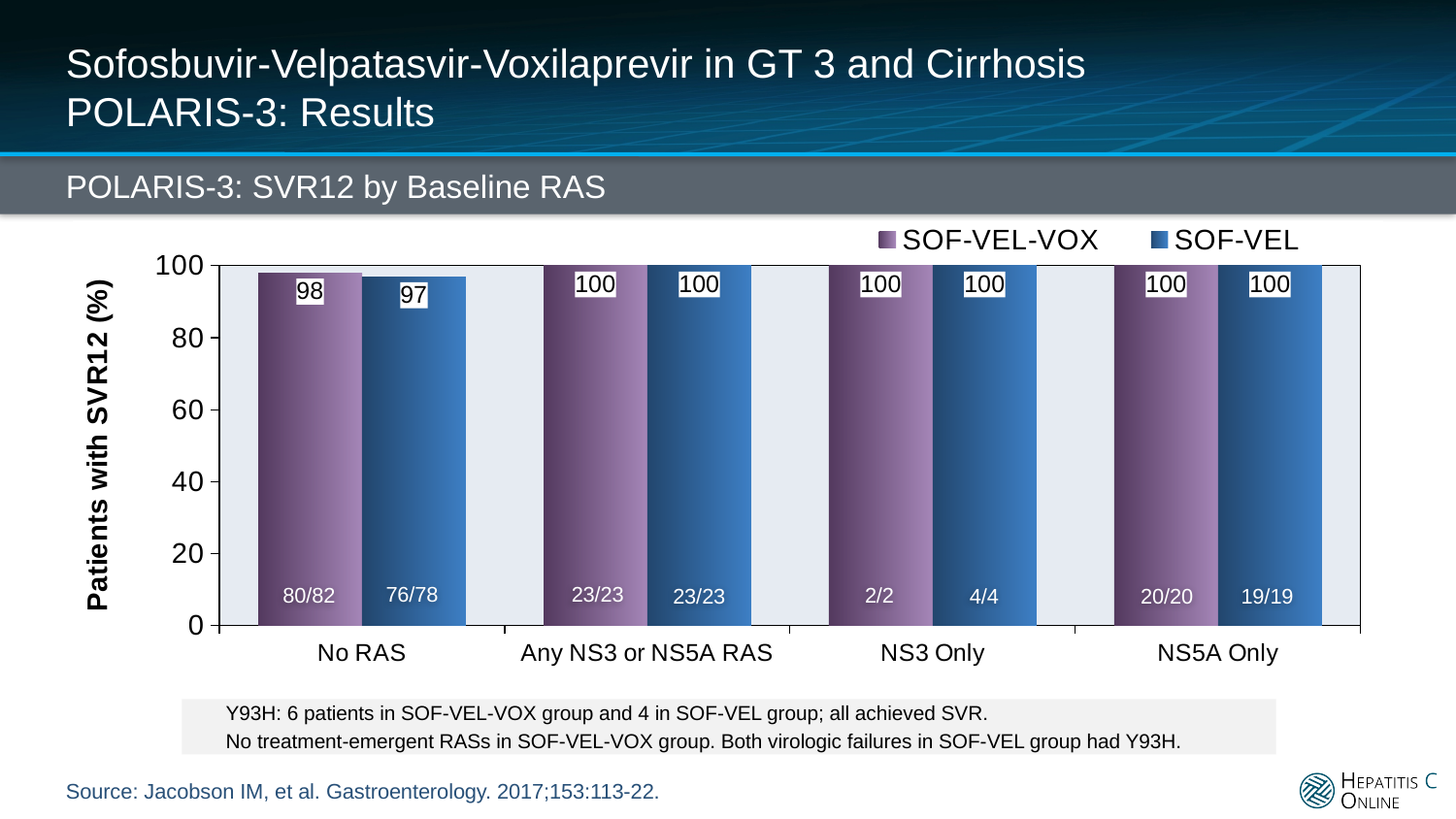
What is the patient fraction shown for SOF-VEL-VOX in the NS5A Only group? 20/20 What is the SVR12 rate for SOF-VEL-VOX in the No RAS group? 98 How many categories are shown on the x axis? 4 What is the difference between the SOF-VEL-VOX and SOF-VEL SVR12 rates in the No RAS group? 1 How many series does the legend list? 2 What is the label of the y axis? Patients with SVR12 (%) What kind of chart is shown on the slide? Bar chart What is the SVR12 rate for SOF-VEL in the No RAS group? 97 What is the patient fraction shown for SOF-VEL in the No RAS group? 76/78 In the No RAS group, which series has the higher SVR12 rate, SOF-VEL-VOX or SOF-VEL? SOF-VEL-VOX Which category has the lowest SVR12 rate for SOF-VEL? No RAS What is the SVR12 rate for SOF-VEL in the NS3 Only group? 100